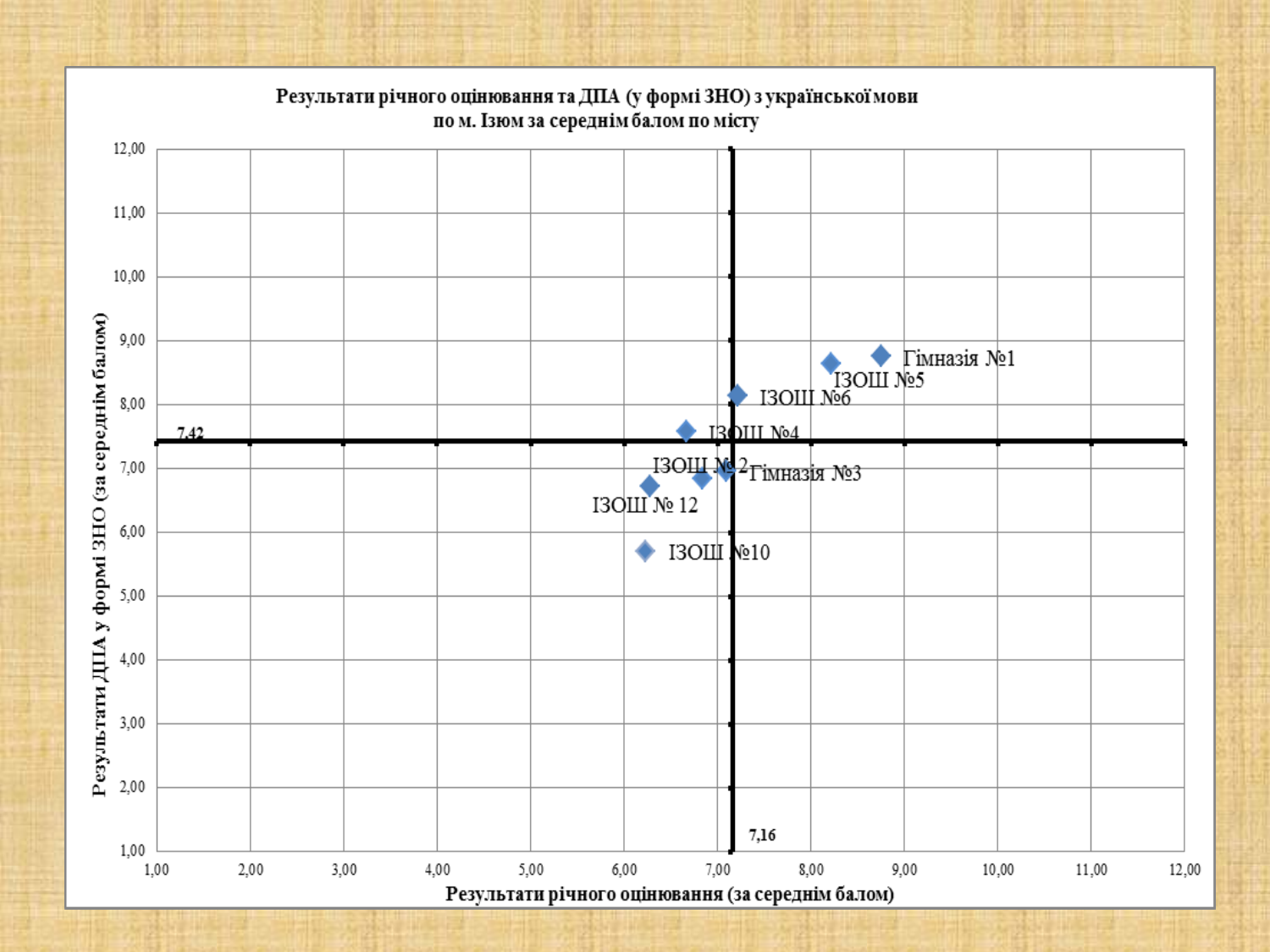
What is the label of the horizontal axis? Результати річного оцінювання (за середнім балом) Which school has the highest ДПА (ЗНО) result on the vertical axis? Гімназія №1 How many schools are plotted as points on the chart? 8 Which has the higher ДПА (ЗНО) result, ІЗОШ №6 or ІЗОШ №4? ІЗОШ №6 Is the ДПА (ЗНО) value for ІЗОШ №10 greater or less than 6,00? less What kind of chart is shown on the slide? scatter chart Which school has the lowest ДПА (ЗНО) result on the vertical axis? ІЗОШ №10 Is the ДПА (ЗНО) value for ІЗОШ №6 greater or less than 8,00? greater Is the annual assessment value for Гімназія №1 greater or less than 8,00? greater What value is printed on the horizontal reference line? 7,42 What value is printed on the vertical reference line? 7,16